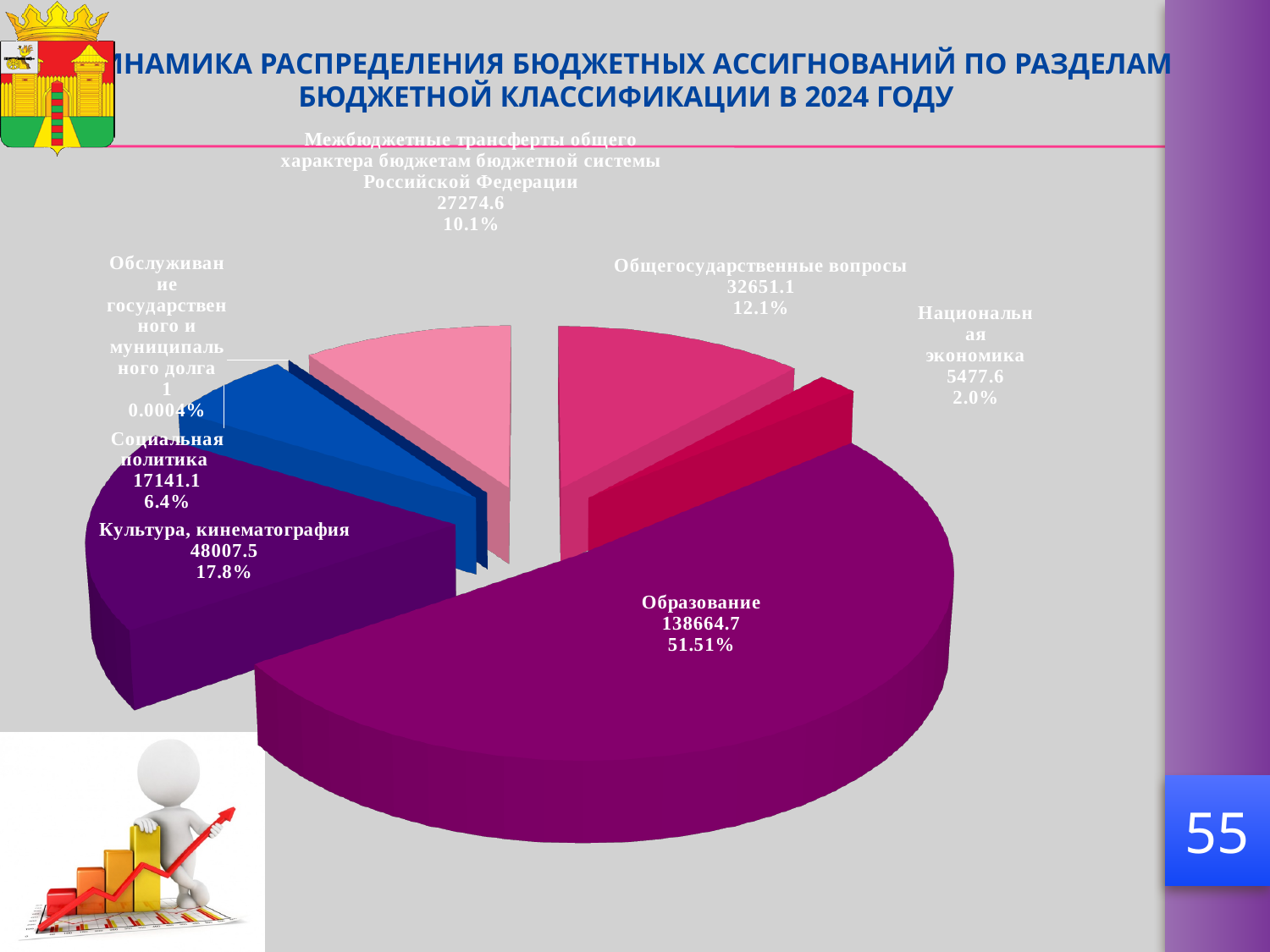
What is the value shown for Культура, кинематография? 48007.5 What percentage is shown for Национальная экономика? 2.0% What is the difference between the values for Культура, кинематография and Социальная политика? 30866.4 Which is larger: the value for Общегосударственные вопросы or the value for Межбюджетные трансферты общего характера бюджетам бюджетной системы Российской Федерации? Общегосударственные вопросы What is the value shown for Общегосударственные вопросы? 32651.1 What kind of chart is shown on the slide? Pie chart What is the value shown for Образование? 138664.7 What share of the pie does Образование represent? 51.51% Which category has the smallest slice of the pie? Обслуживание государственного и муниципального долга How many categories (slices) does the pie chart show? 7 Which category has the largest slice of the pie? Образование What percentage is shown for Социальная политика? 6.4%